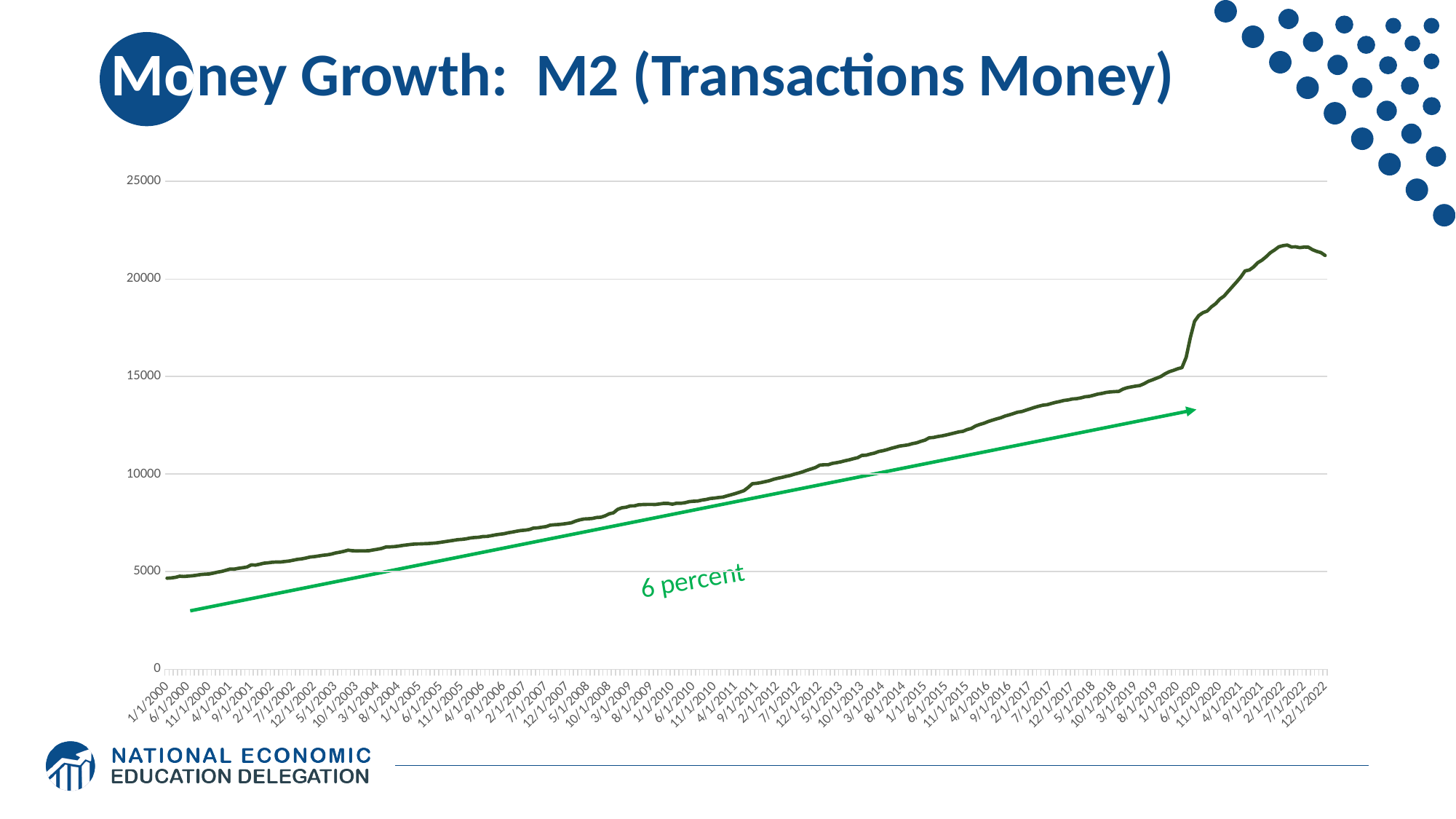
Do the M2 values generally rise or fall from 1/1/2000 to 12/1/2022? rise What is the highest value shown on the vertical axis? 25000 What growth rate is labelled on the green trend arrow? 6 percent Is the value for 1/1/2000 greater or less than 5000? less Is the value for 12/1/2022 greater or less than 20000? greater Is the value for 1/1/2015 greater or less than 15000? less What is the title of the chart on the slide? Money Growth: M2 (Transactions Money) What kind of chart is shown on the slide? line chart Which is larger, the value for 1/1/2000 or the value for 12/1/2022? 12/1/2022